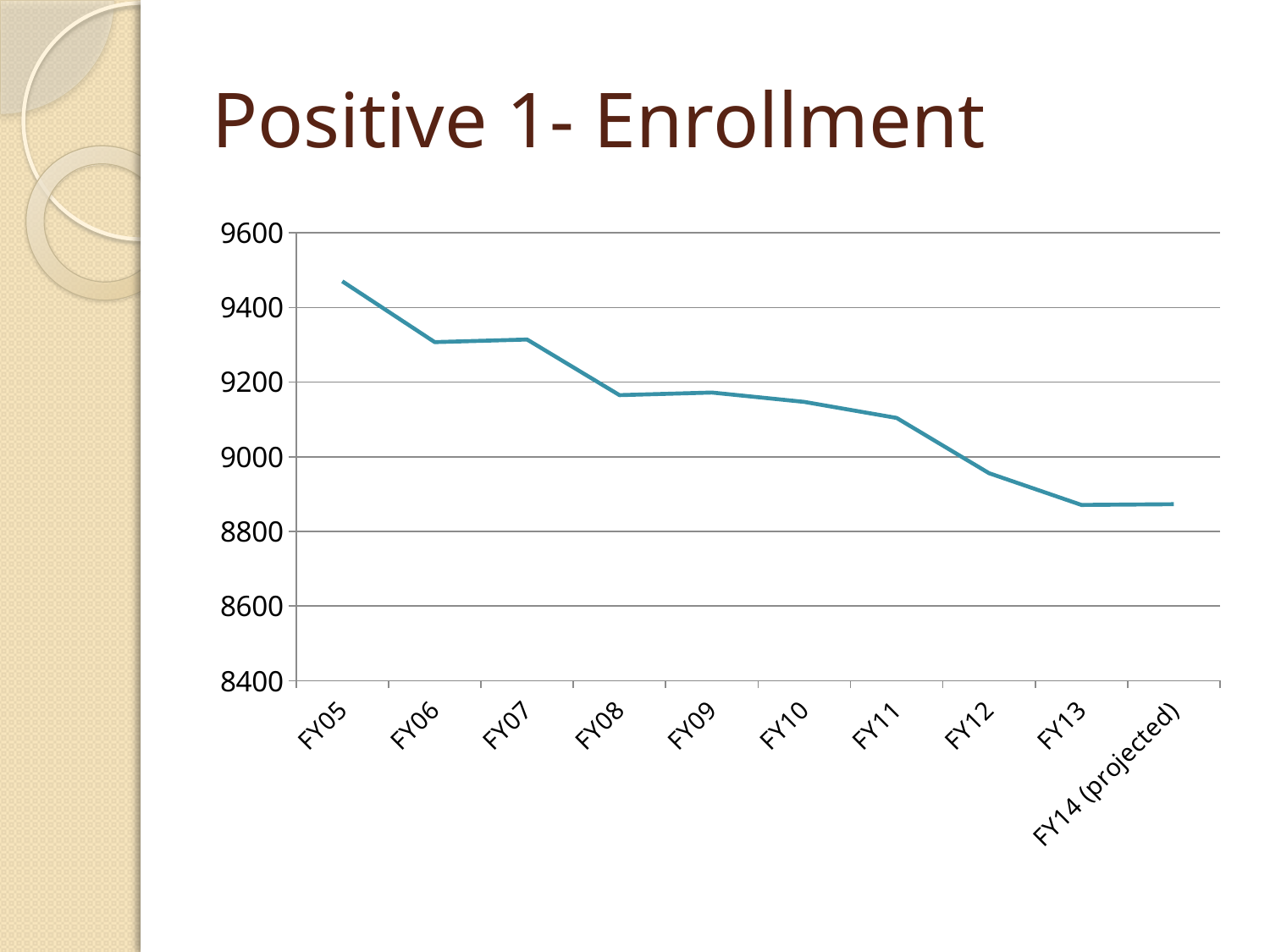
Is the value for FY13 greater or less than 9000? less Is the value for FY12 greater or less than 9000? less What kind of chart is shown on the slide? line chart Which is larger, the value for FY08 or the value for FY13? FY08 Is the value for FY08 greater or less than 9200? less How many fiscal years are plotted on the x axis? 10 Which fiscal year has the highest enrollment? FY05 Which is larger, the value for FY05 or the value for FY12? FY05 What is the title of the slide containing the chart? Positive 1- Enrollment Do enrollment values generally rise or fall from FY05 to FY14 (projected)? fall